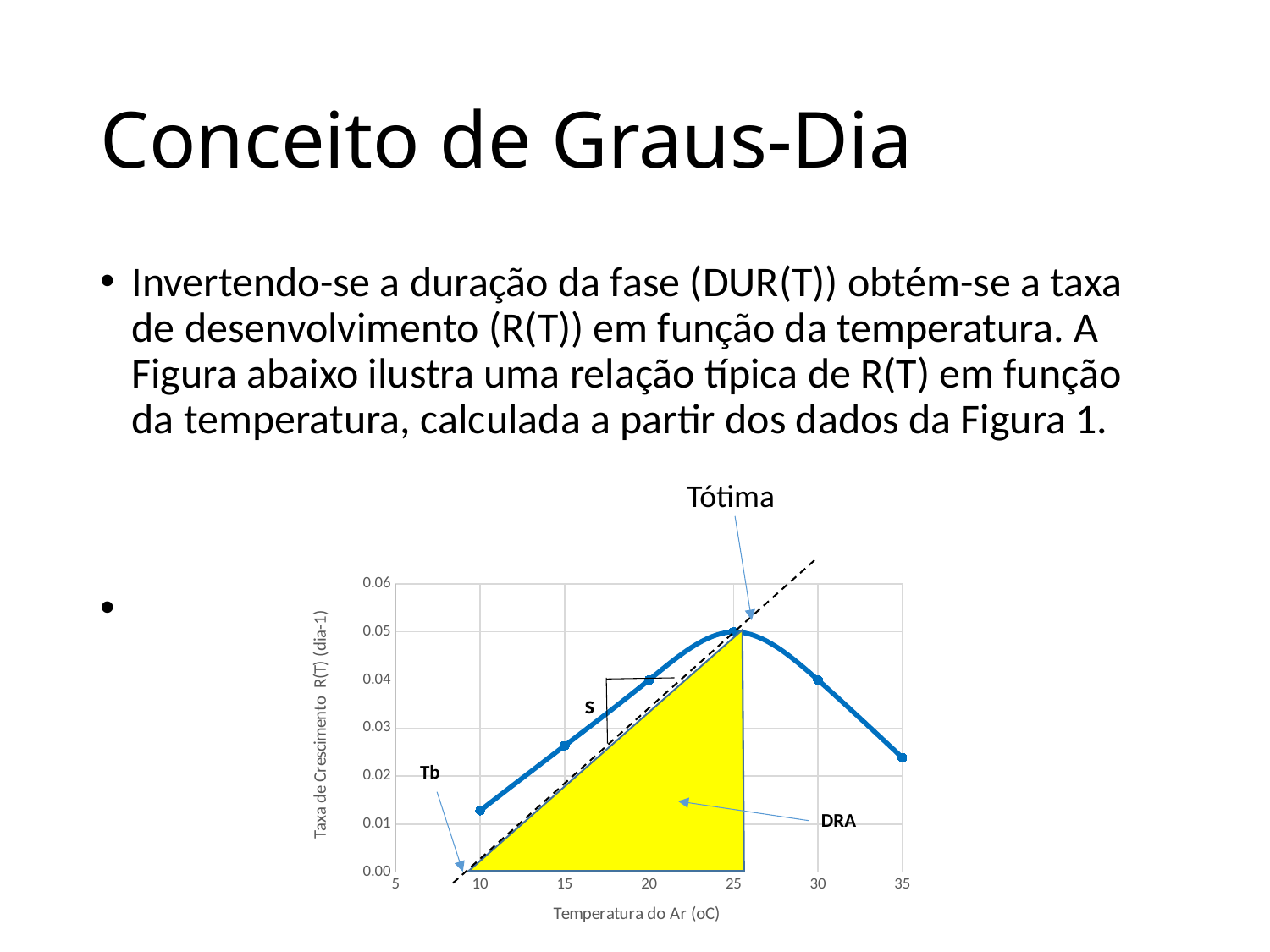
What kind of chart is shown on the slide? line chart Is the value of R(T) at a temperature of 15 greater or less than 0.02? greater Is the value of R(T) at a temperature of 35 greater or less than 0.03? less Does the curve rise or fall between temperatures 25 and 35? fall Is the value of R(T) at a temperature of 10 greater or less than 0.02? less What is the value of R(T) at a temperature of 20? 0.04 How many data points are plotted on the curve? 6 What is the difference between the R(T) values at 25 and at 20? 0.01 What is the value of R(T) at a temperature of 25? 0.05 At which temperature does the curve reach its highest value of R(T)? 25 At which temperature is the plotted value of R(T) lowest? 10 Which has a larger R(T) value: the point at 15 or the point at 30? 30